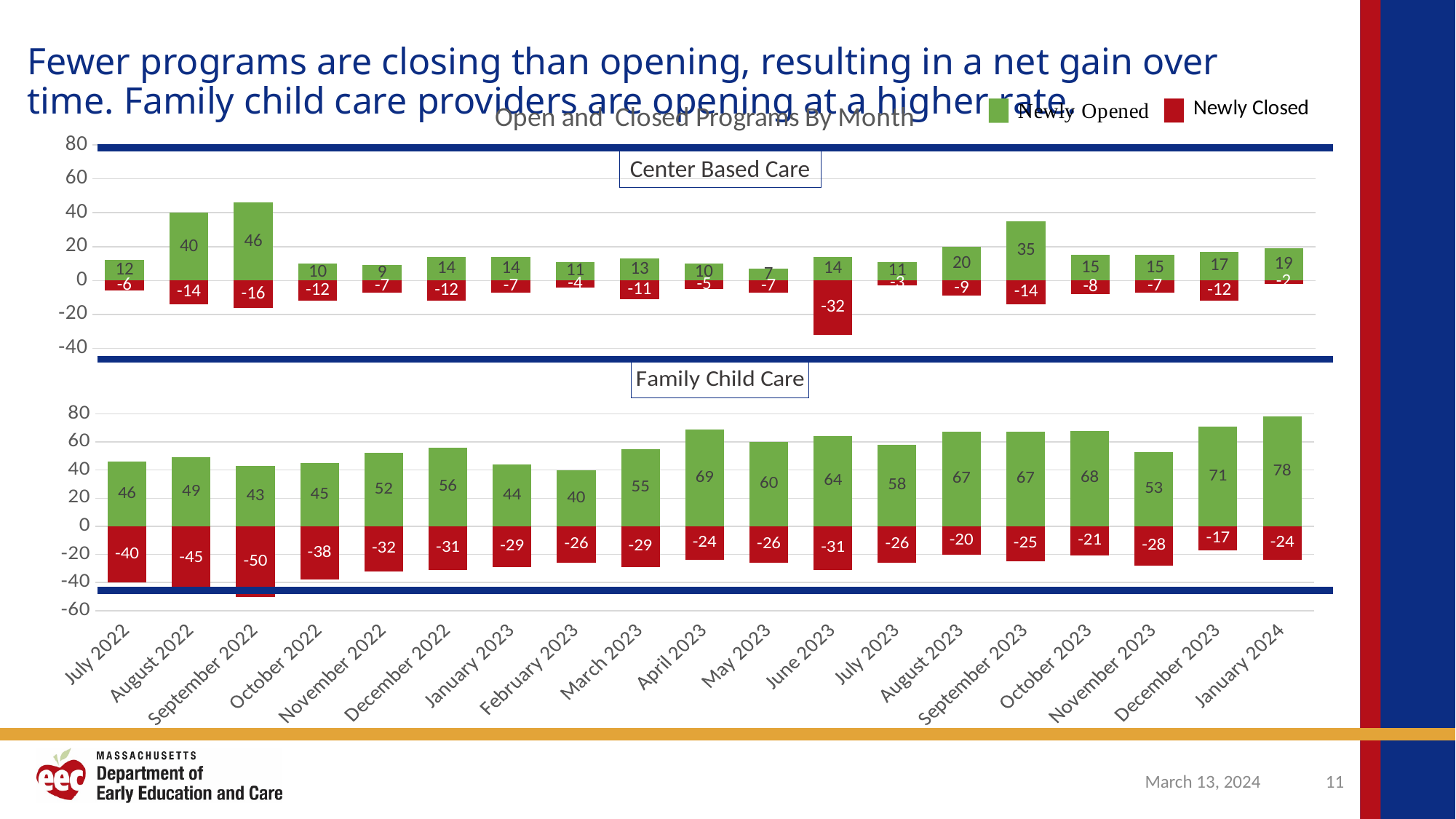
In the Center Based Care chart, what is the Newly Closed value for June 2023? -32 In the Center Based Care chart, how many programs were newly opened in September 2022? 46 In the Center Based Care chart, which month has the highest Newly Opened value? September 2022 In the Family Child Care chart, how many programs were newly opened in January 2024? 78 In the Family Child Care chart, what is the Newly Closed value for September 2022? -50 In the Family Child Care chart, what is the difference between the Newly Opened values for January 2024 and July 2022? 32 In the Family Child Care chart, which month has the lowest Newly Opened value? February 2023 Which colour represents Newly Closed programs in the charts? Red What kind of chart is the Family Child Care chart? Bar chart How many months are shown on the x axis of the Family Child Care chart? 19 How many series does the legend list? 2 In the Center Based Care chart, which is larger: the Newly Opened value for August 2022 or for September 2023? August 2022